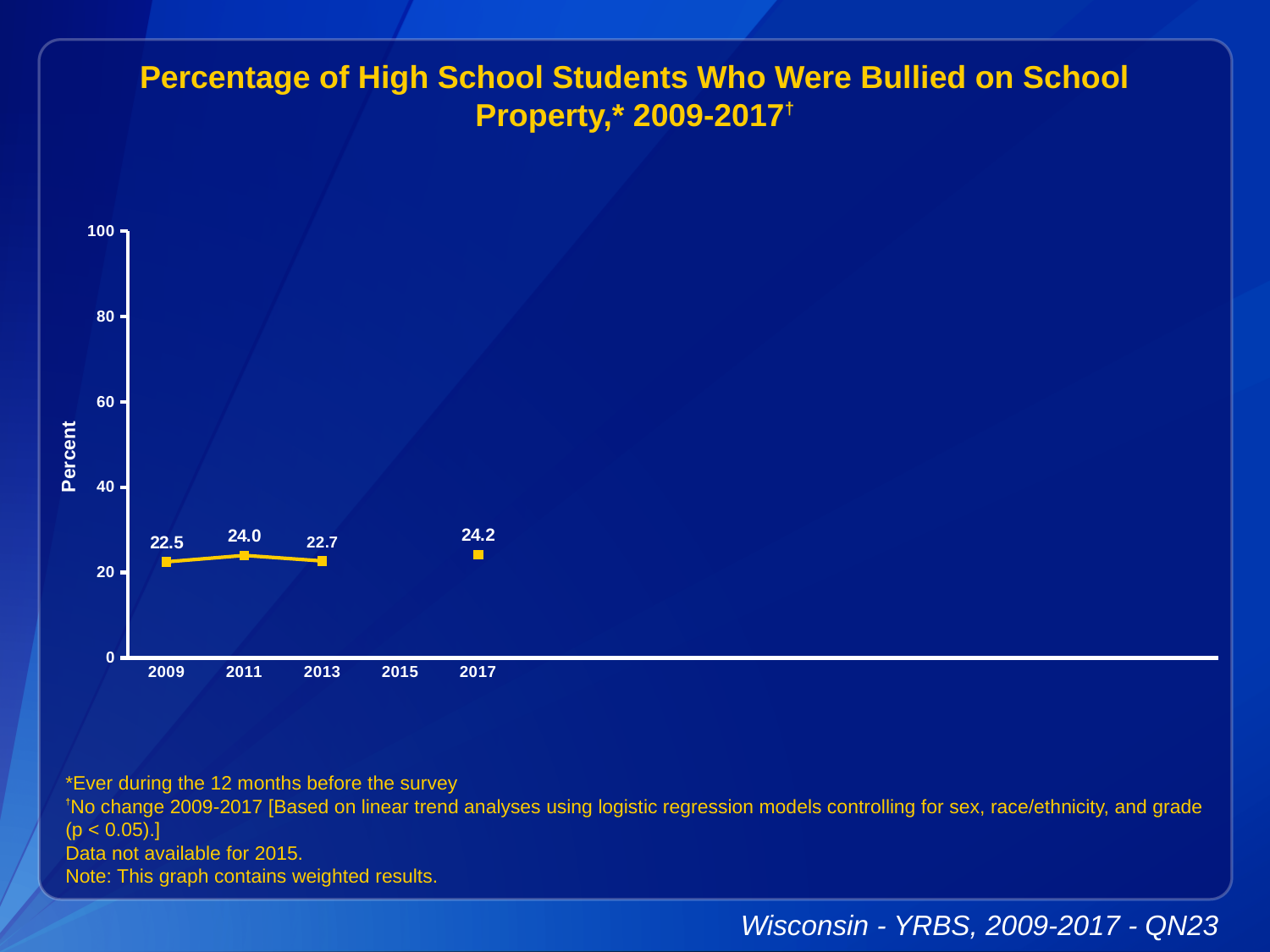
Which year has a larger value, 2011 or 2013? 2011 What was the percentage of high school students bullied on school property in 2011? 24.0 What kind of chart is shown on the slide? line chart What was the percentage of high school students bullied on school property in 2017? 24.2 What is the label on the y axis of the chart? Percent Which year has the highest percentage of students bullied on school property? 2017 How many years have data points plotted on the chart? 4 What was the percentage of high school students bullied on school property in 2009? 22.5 What is the difference between the 2017 value and the 2009 value? 1.7 What was the percentage of high school students bullied on school property in 2013? 22.7 Which year has the lowest percentage of students bullied on school property? 2009 Is the value for 2017 greater or less than 40? less